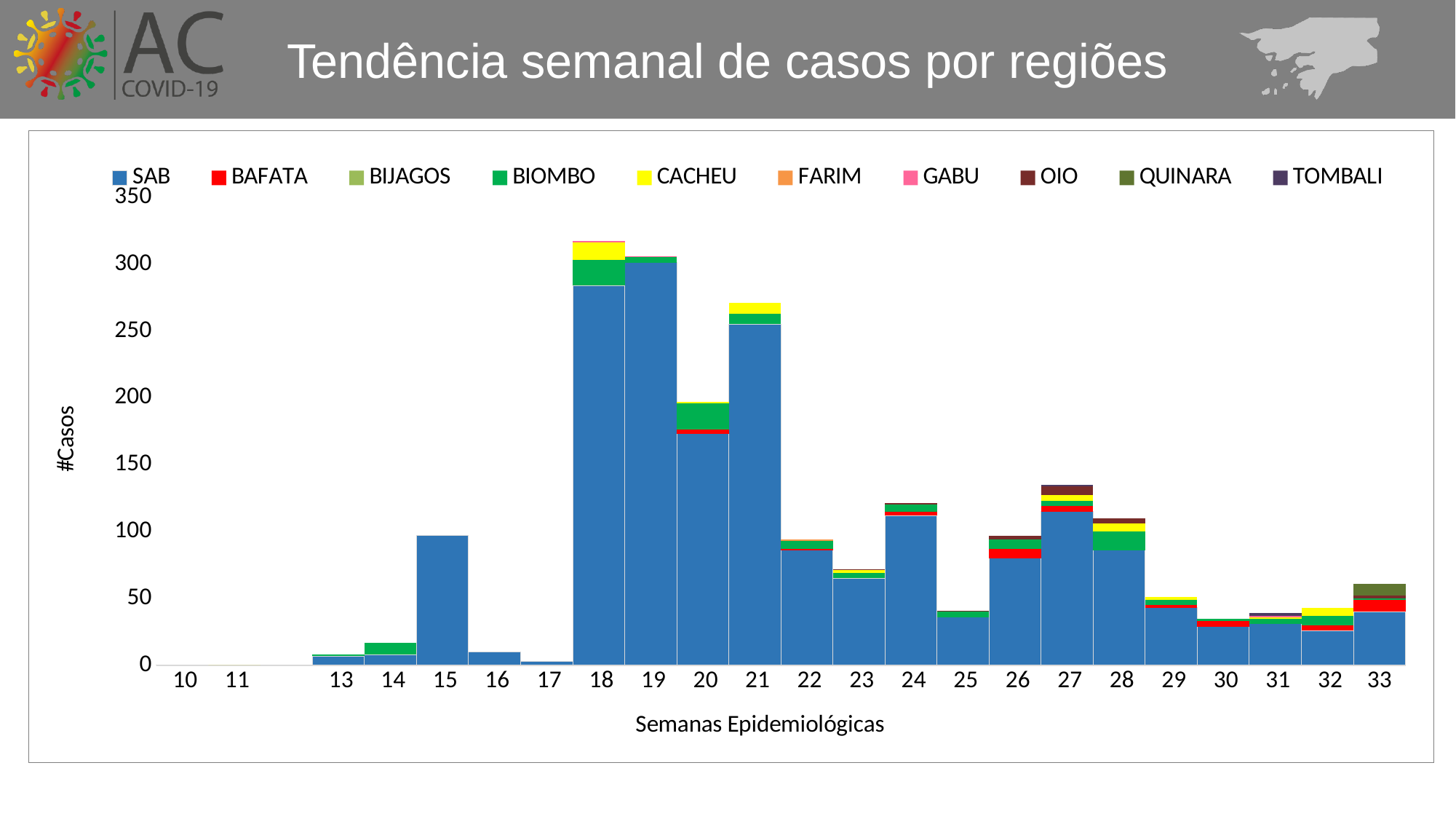
Is the total for week 25 greater or less than 50? less Do the bar totals rise or fall from week 19 to week 22? Fall Which bar is taller, week 15 or week 16? Week 15 Is the total for week 27 greater or less than 100? greater Is the total for week 18 greater or less than 300? greater What kind of chart is shown on the slide? Stacked bar chart What is the title of the chart's vertical axis? #Casos Which bar is taller, week 24 or week 23? Week 24 Which epidemiological week has the tallest bar? 18 How many series does the legend list? 10